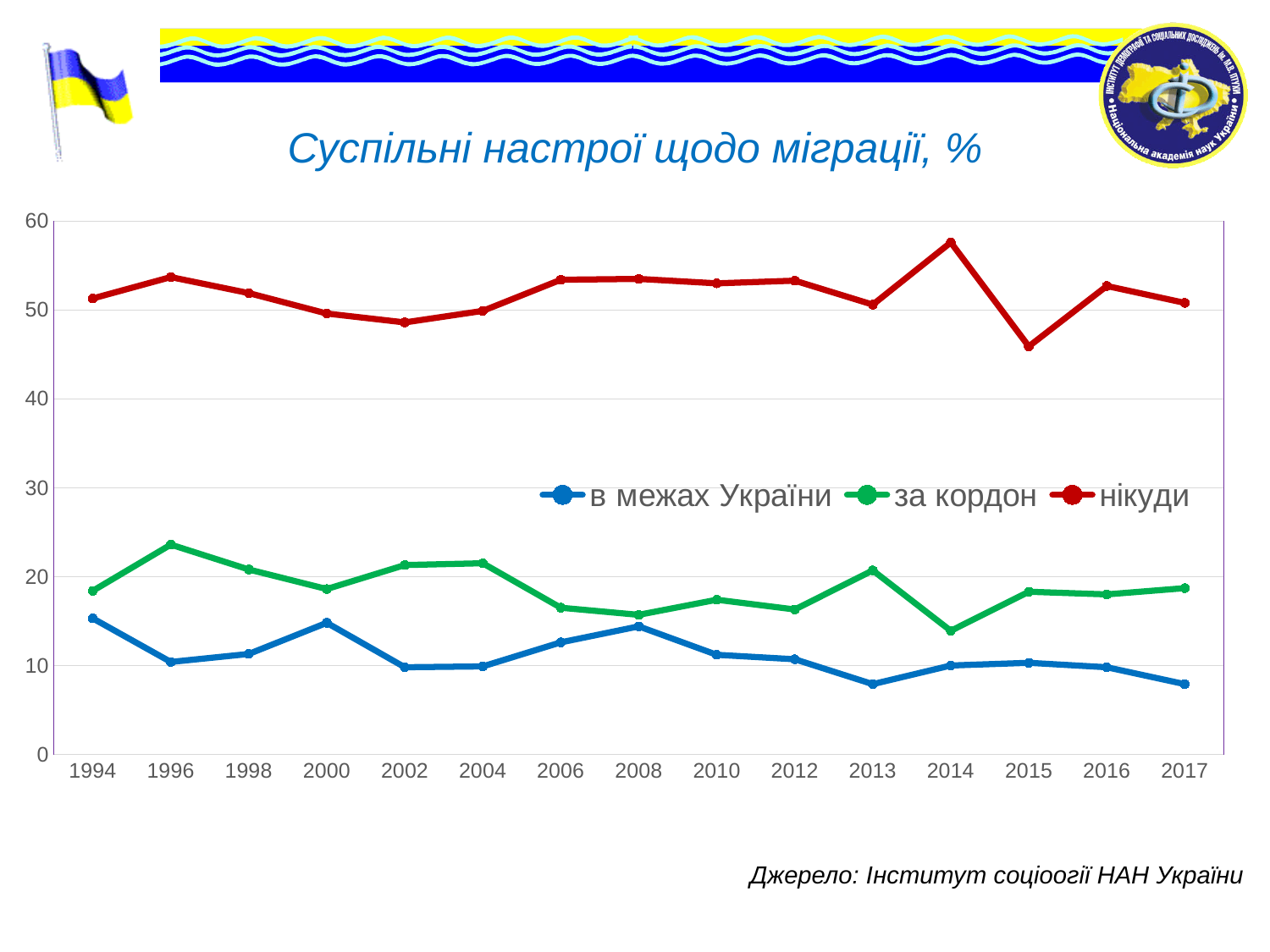
In which year does the series "нікуди" reach its highest value? 2014 In which year does the series "за кордон" reach its lowest value? 2014 Is the value for "в межах України" in 2013 greater or less than 10? less How many years are plotted along the x axis? 15 In 2017, which series has the larger value: "за кордон" or "в межах України"? за кордон In which year does the series "нікуди" reach its lowest value? 2015 Is the value for "за кордон" in 1996 greater or less than 20? greater What is the title of the chart? Суспільні настрої щодо міграції, % In which year does the series "за кордон" reach its highest value? 1996 How many series does the legend list? 3 What kind of chart is shown on the slide? line chart Is the value for "нікуди" in 2015 greater or less than 50? less